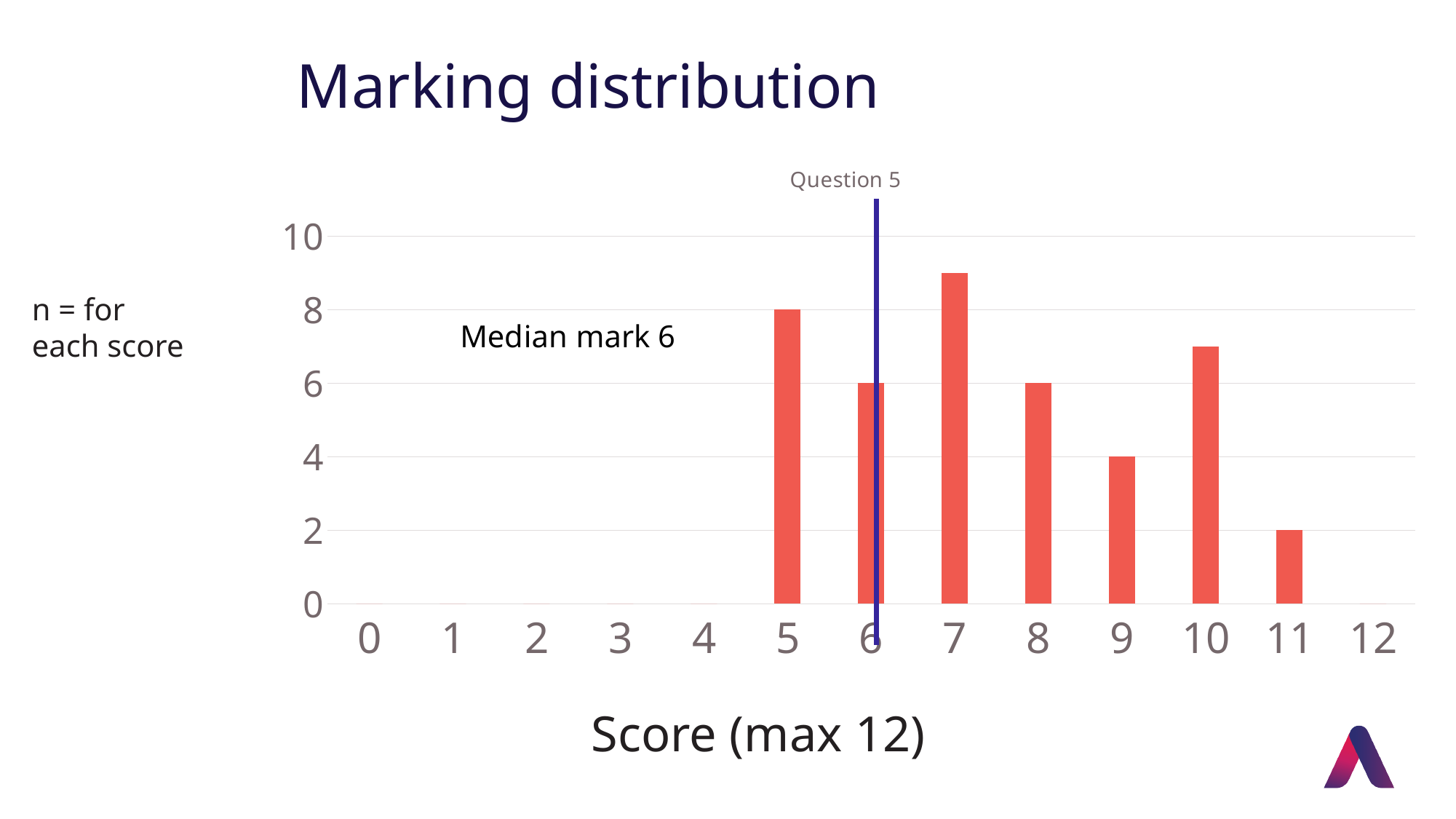
What is the difference between the values for score 5 and score 6? 2 What type of chart is shown on the slide? bar chart Is the value for score 7 greater or less than 8? greater How many scores have a bar plotted on the chart? 7 What is the value (n) for a score of 5? 8 Which score has the highest bar? 7 What is the title of the chart? Question 5 What is the value (n) for a score of 6? 6 Is the value for score 10 greater or less than 6? greater What is the value (n) for a score of 11? 2 Which score has the lowest non-zero bar? 11 What is the value (n) for a score of 9? 4